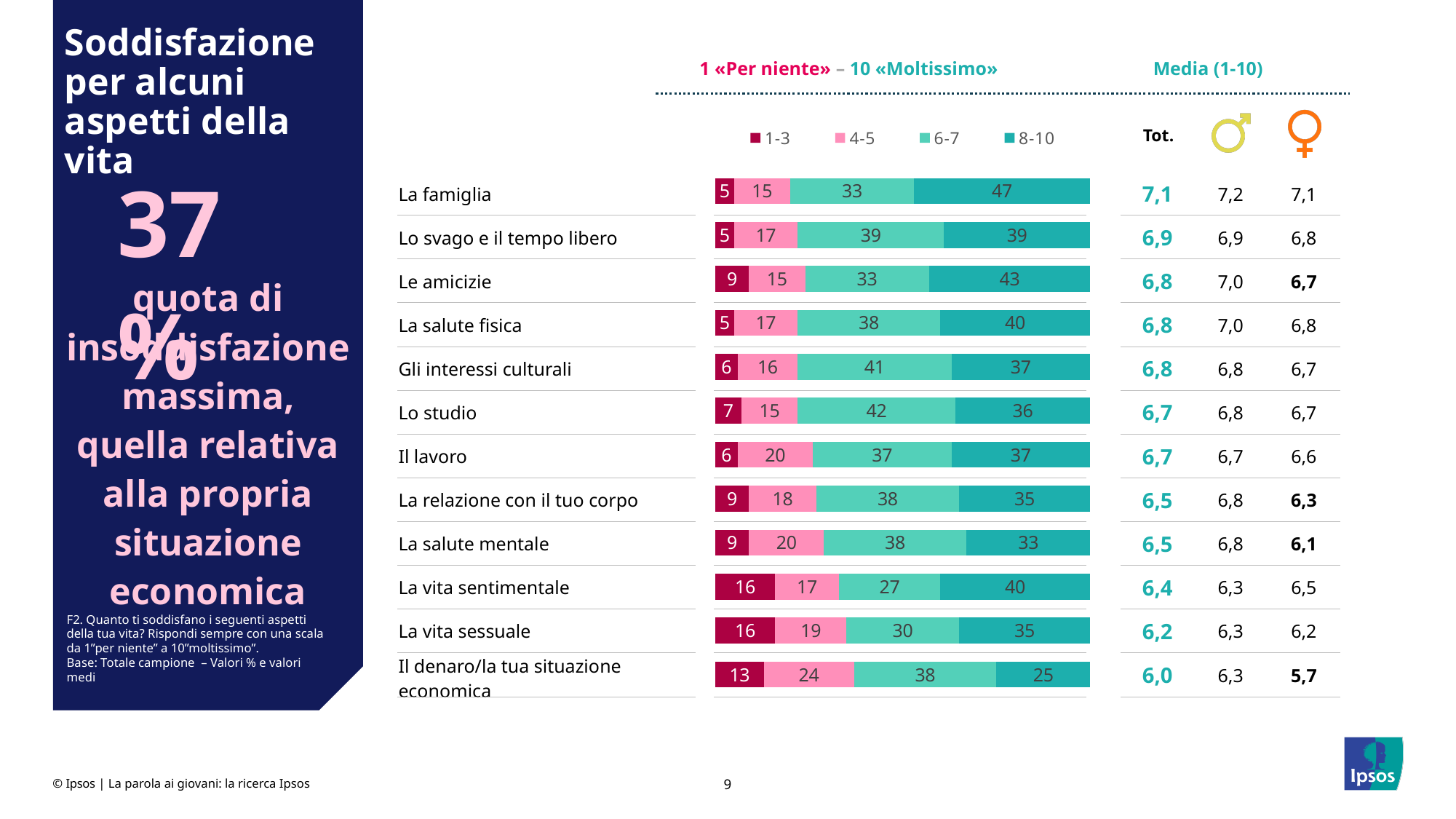
What is the total of the stacked bar for Le amicizie? 100 Which category has the lowest value in the 8-10 series? Il denaro/la tua situazione economica Which category has the highest value in the 8-10 series? La famiglia What is the value of the 1-3 segment for La vita sentimentale? 16 What kind of chart is shown on the slide? Stacked bar chart What is the value of the 8-10 segment for La famiglia? 47 How many categories are shown in the bar chart? 12 What is the value of the 4-5 segment for La salute mentale? 20 Which has the larger 4-5 value, Il denaro/la tua situazione economica or La famiglia? Il denaro/la tua situazione economica What is the value of the 6-7 segment for Lo studio? 42 How many series does the legend list? 4 What is the difference between the 8-10 values for La famiglia and Il denaro/la tua situazione economica? 22